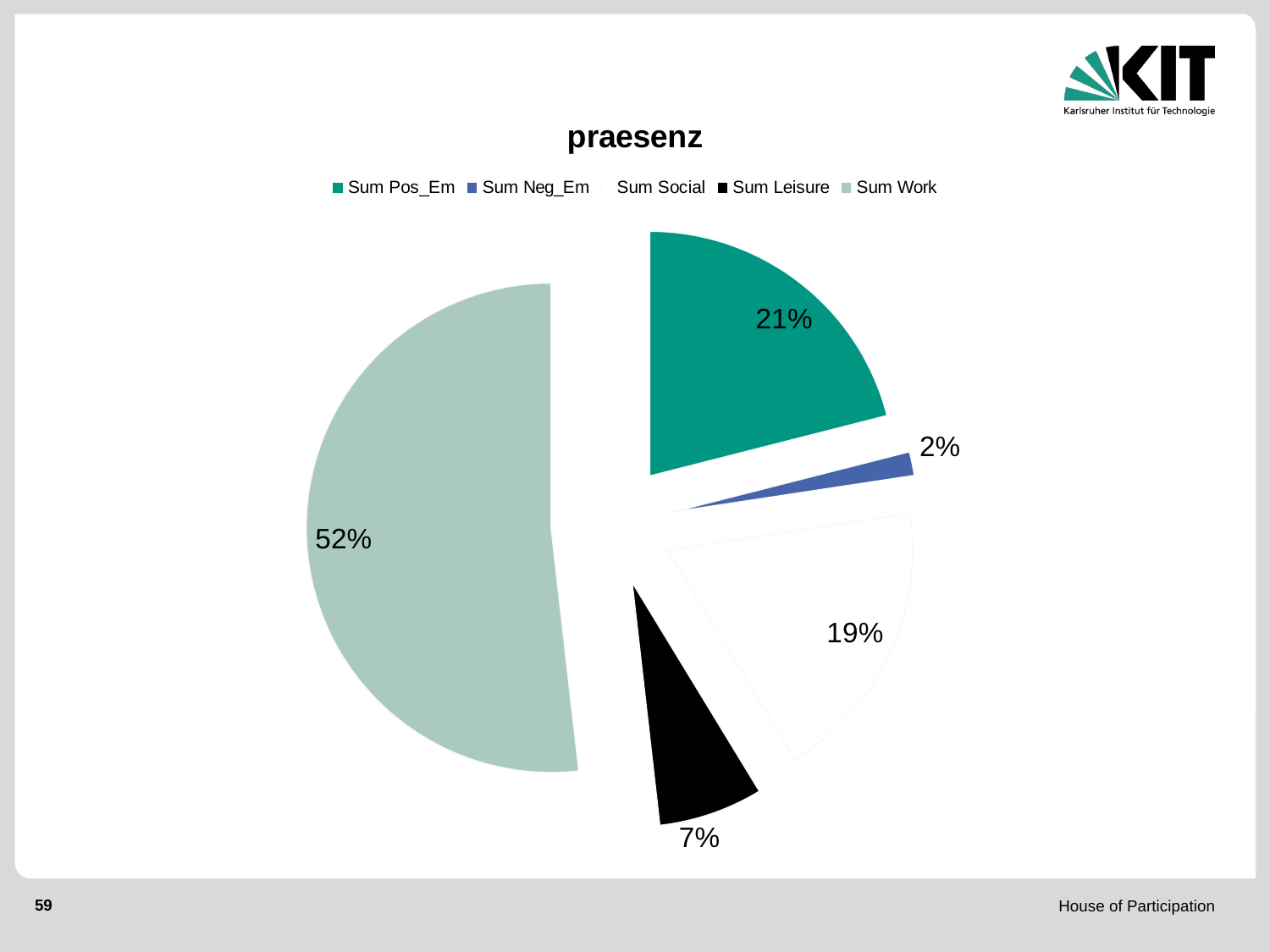
Which category has the largest slice of the pie? Sum Work What is the difference in percentage points between Sum Work and Sum Pos_Em? 31 What type of chart is shown on the slide? pie chart What share of the pie does Sum Work have? 52% What share of the pie does Sum Leisure have? 7% What share of the pie does Sum Social have? 19% How many slices does the pie chart have? 5 Which category has the smallest slice of the pie? Sum Neg_Em What is the title of the chart? praesenz Which is larger, the share for Sum Social or the share for Sum Leisure? Sum Social